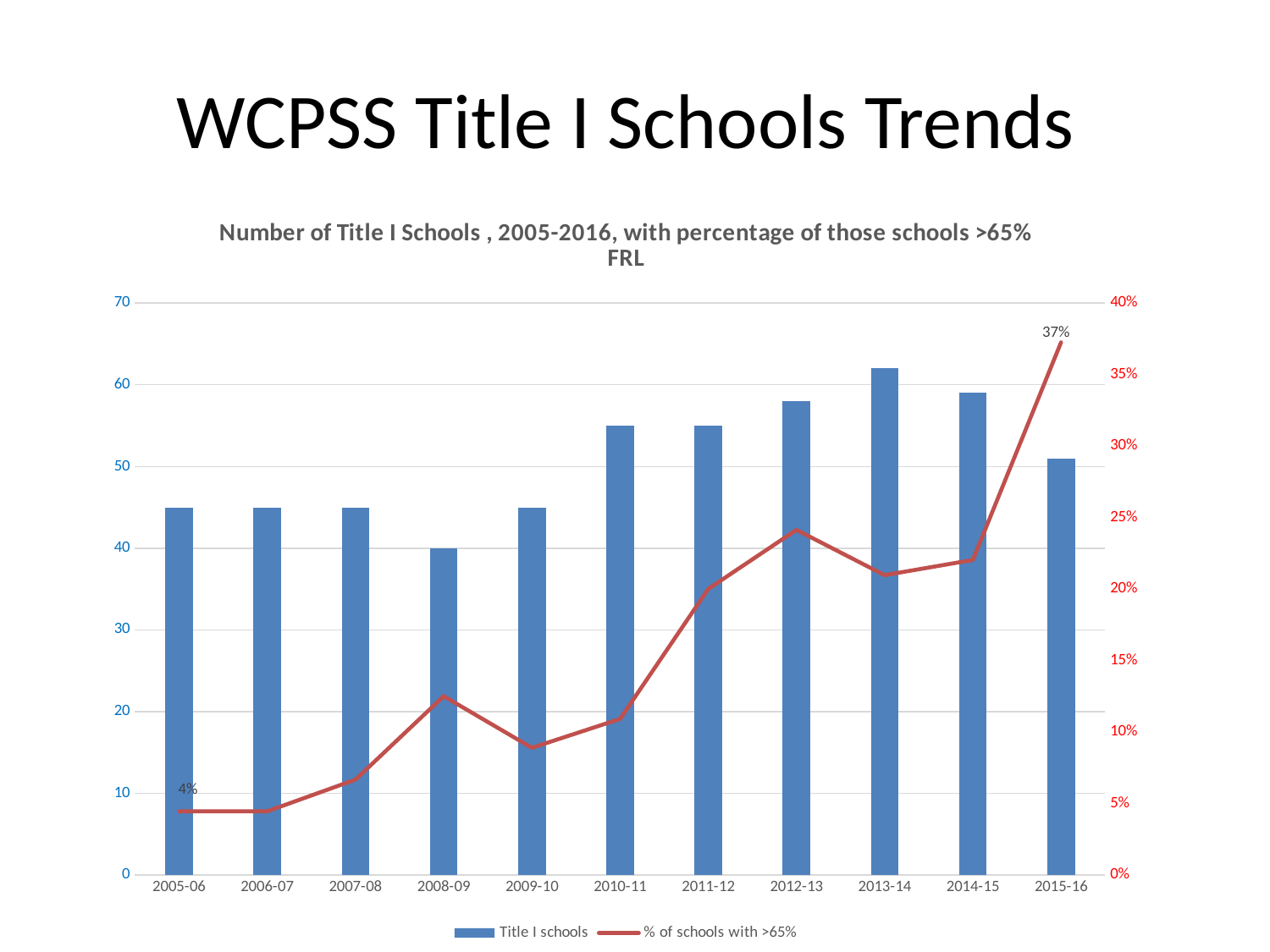
Is the percentage of schools with >65% FRL in 2012-13 greater or less than 20%? greater What percentage of schools with >65% FRL is shown for 2005-06? 4% Is the number of Title I schools in 2013-14 greater or less than 60? greater What percentage of schools with >65% FRL is shown for 2015-16? 37% Is the number of Title I schools in 2005-06 greater or less than 50? less Does the percentage of schools with >65% FRL generally rise or fall from 2005-06 to 2015-16? rise How many Title I schools are shown for 2008-09? 40 By how many percentage points did the share of schools with >65% FRL increase from 2005-06 to 2015-16? 33 percentage points How many school years are shown on the x axis? 11 How many series does the legend list? 2 Which school year has the highest number of Title I schools? 2013-14 Which school year has the lowest number of Title I schools? 2008-09